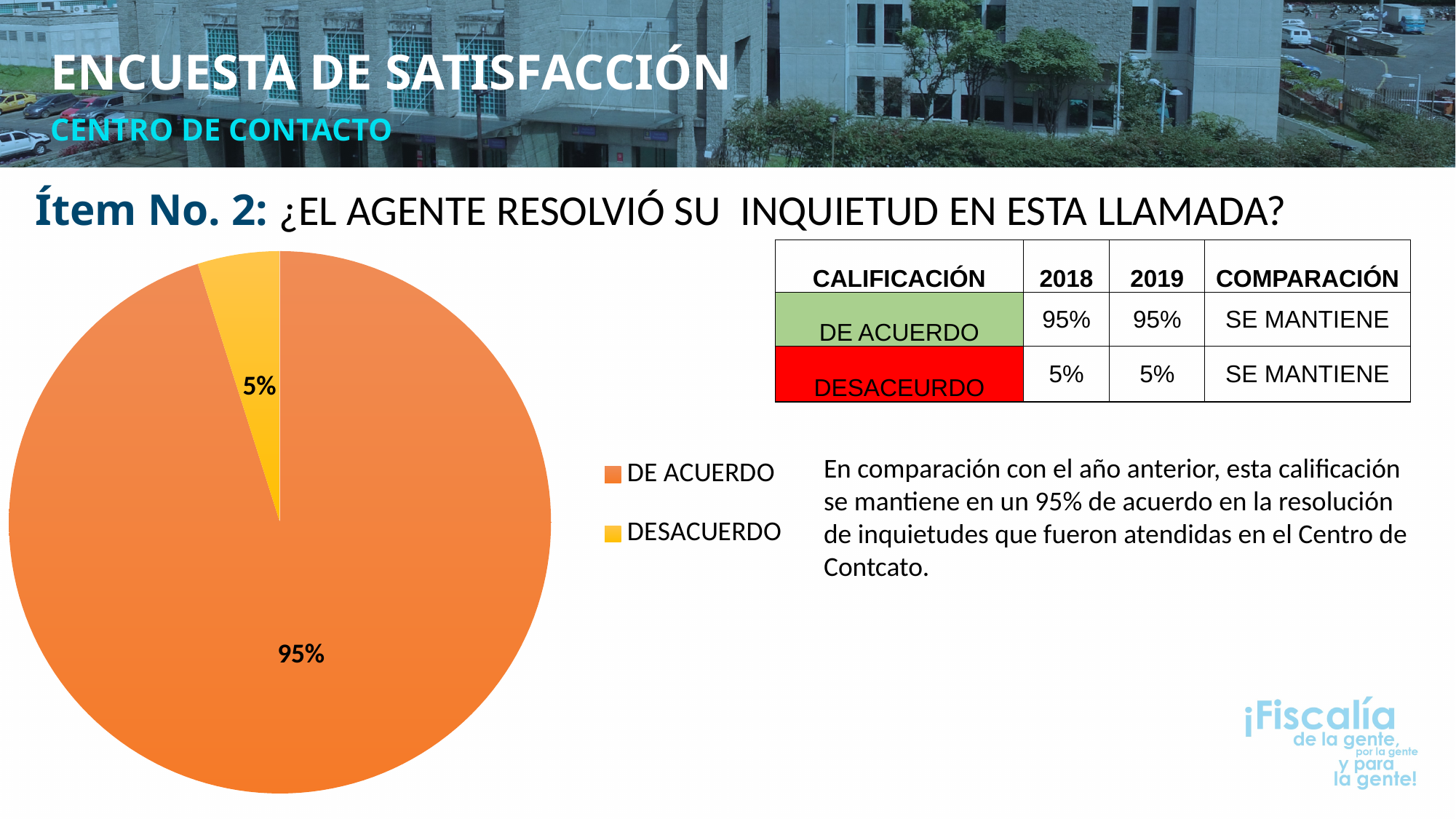
How many entries does the legend of the pie chart list? 2 Which slice of the pie chart is the largest? DE ACUERDO Which is larger in the pie chart, DE ACUERDO or DESACUERDO? DE ACUERDO What share of the pie does DESACUERDO represent? 5% What is the difference in percentage points between the DE ACUERDO and DESACUERDO slices? 90 What share of the pie does DE ACUERDO represent? 95% How many slices does the pie chart have? 2 What colour is the DE ACUERDO slice in the pie chart? orange What colour is the DESACUERDO slice in the pie chart? yellow What kind of chart is shown on the slide? pie chart Which slice of the pie chart is the smallest? DESACUERDO